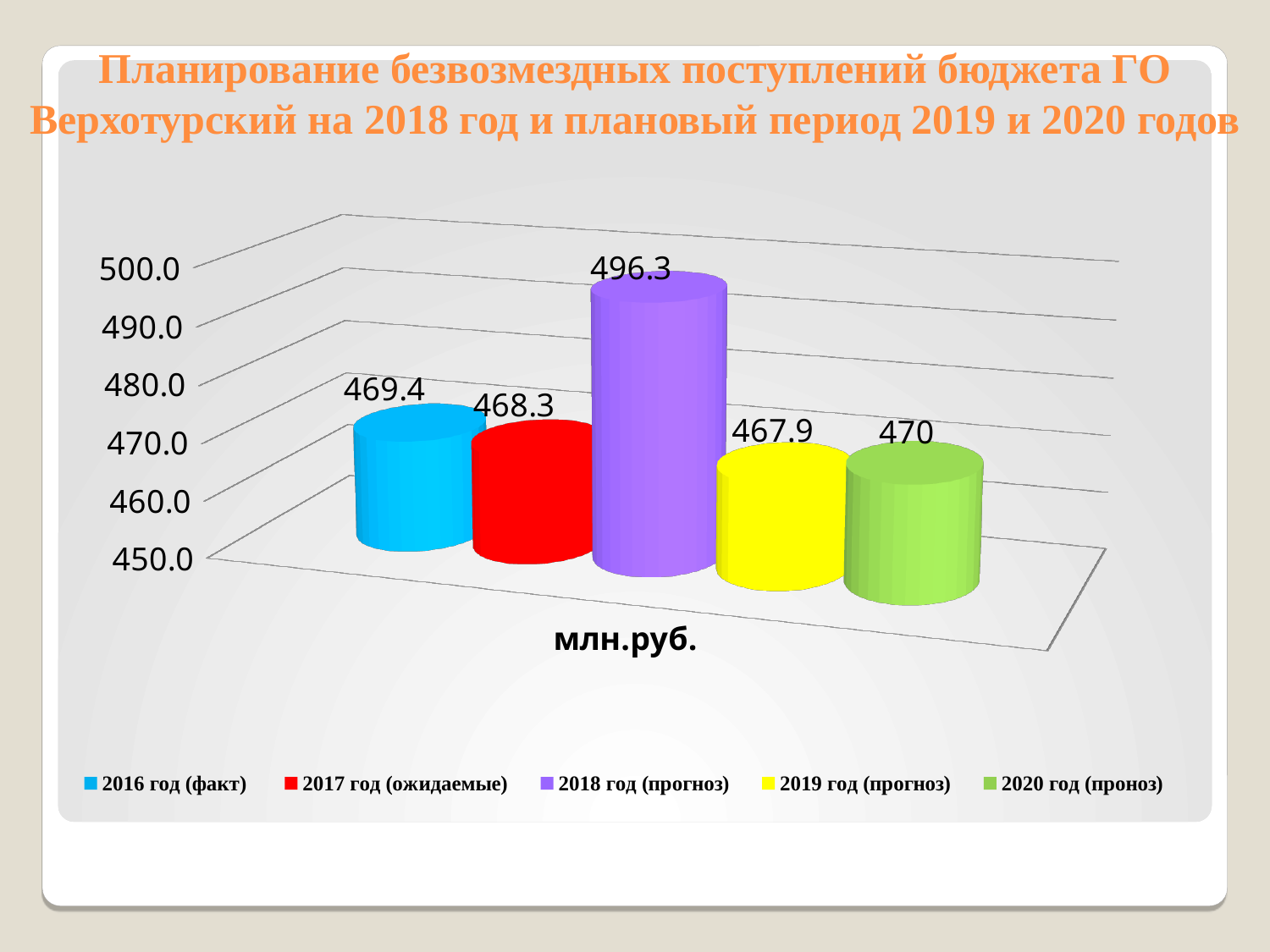
How many series does the legend list? 5 What is the value for 2016 год (факт)? 469.4 What is the difference between the values for 2018 год (прогноз) and 2017 год (ожидаемые)? 28 What unit label is shown below the bars on the chart? млн.руб. What is the value for 2020 год (проноз)? 470 What is the value for 2018 год (прогноз)? 496.3 What is the value for 2019 год (прогноз)? 467.9 Which series has the highest value? 2018 год (прогноз) Which series has the lowest value? 2019 год (прогноз) Which is larger, the value for 2016 год (факт) or the value for 2020 год (проноз)? 2020 год (проноз) What kind of chart is shown on the slide? bar chart What is the value for 2017 год (ожидаемые)? 468.3